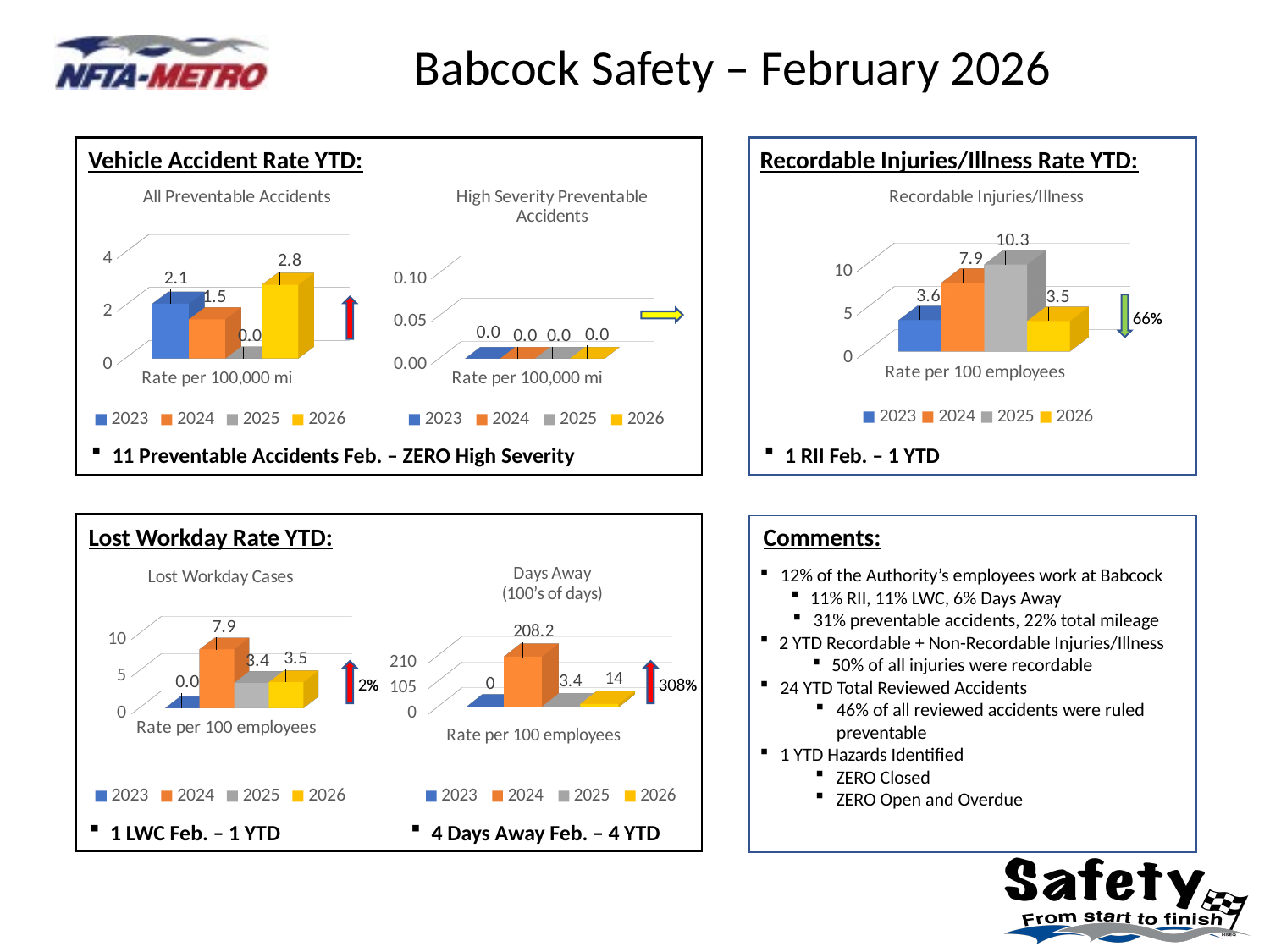
In the Lost Workday Cases chart, what is the difference between the 2024 and 2025 values? 4.5 In the All Preventable Accidents chart, what is the value for 2026? 2.8 In the Days Away chart, what is the value for 2024? 208.2 In the Recordable Injuries/Illness chart, what is the value for 2024? 7.9 In the All Preventable Accidents chart, which year has the highest rate? 2026 In the Recordable Injuries/Illness chart, which year has the highest value? 2025 How many series does the legend of the Recordable Injuries/Illness chart list? 4 In the Recordable Injuries/Illness chart, is the value for 2025 greater or less than 10? greater In the All Preventable Accidents chart, what is the difference between the 2023 and 2024 values? 0.6 In the Days Away chart, which is larger, the value for 2025 or the value for 2026? 2026 In the Lost Workday Cases chart, which year has the lowest value? 2023 In the High Severity Preventable Accidents chart, what is the value for 2025? 0.0